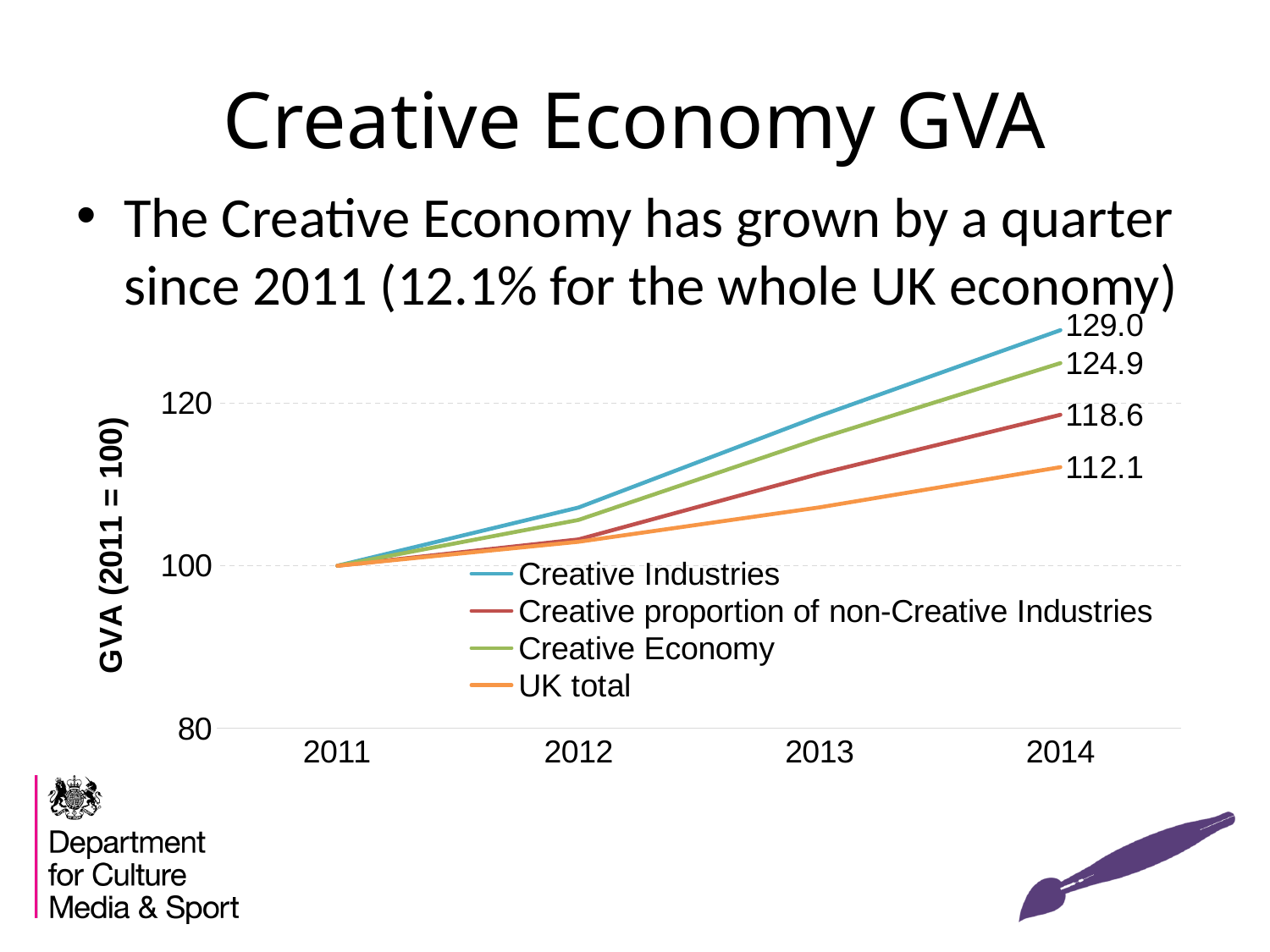
Which is larger in 2014: Creative Economy or Creative proportion of non-Creative Industries? Creative Economy Is the 2013 value for UK total greater or less than 120? less How many series does the chart legend list? 4 What is the 2014 value for Creative Industries? 129.0 Which series has the highest value in 2014? Creative Industries What is the 2014 value for the Creative Economy series? 124.9 What is the 2014 value for Creative proportion of non-Creative Industries? 118.6 What kind of chart is shown on the slide? line chart What is the 2014 value for UK total? 112.1 What is the difference between the 2014 values for Creative Industries and UK total? 16.9 Do the values for Creative Industries rise or fall from 2011 to 2014? rise Which series has the lowest value in 2014? UK total